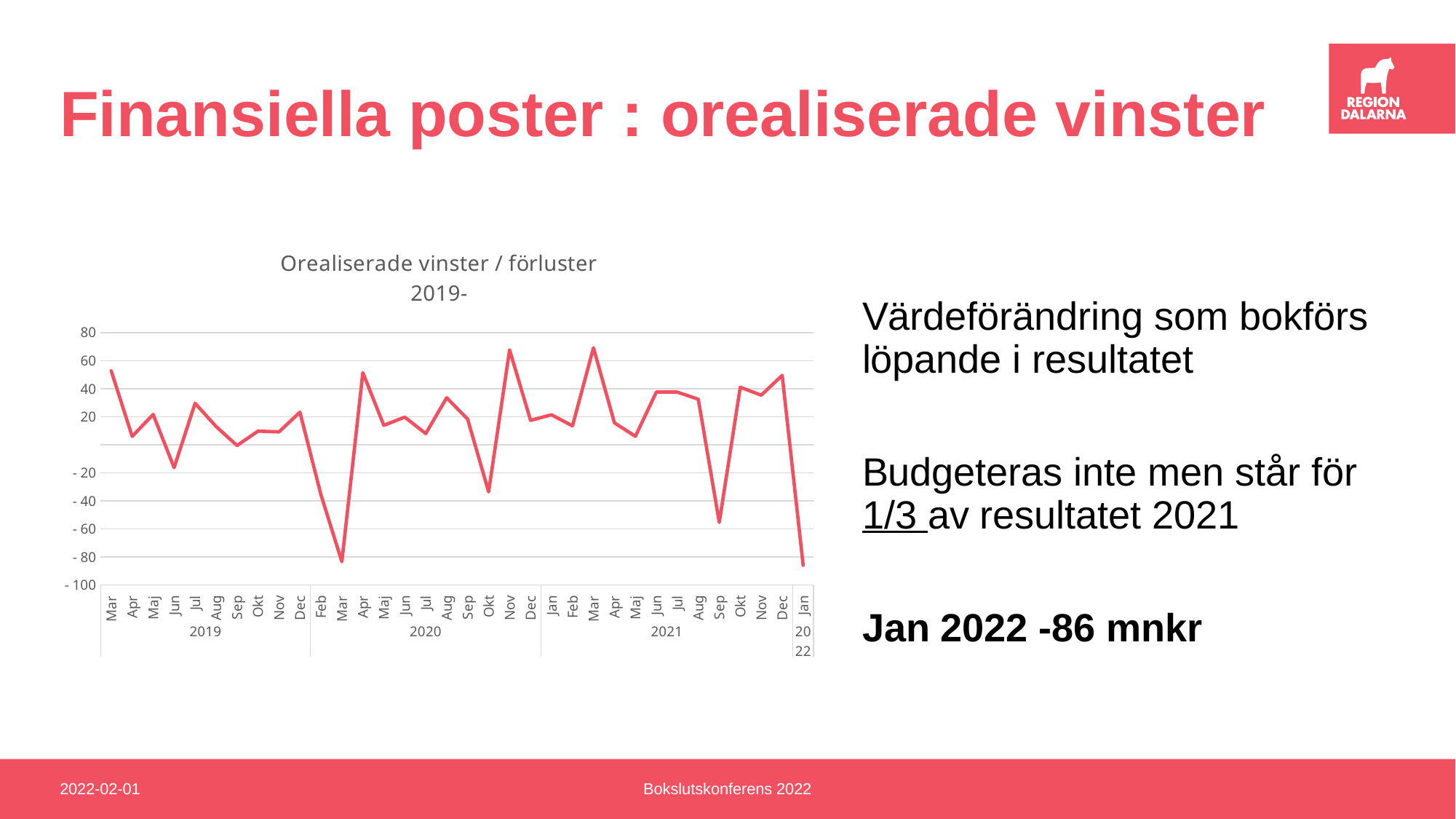
Is the value for Okt 2020 greater or less than -20? less Which is larger, the value for Sep 2021 or the value for Okt 2021? Okt 2021 What is the value for Jan 2022 according to the slide? -86 mnkr Is the value for Mar 2020 greater or less than -60? less How many different years are labelled on the x axis of the chart? 4 What kind of chart is shown on the slide? line chart Which is larger, the value for Mar 2019 or the value for Apr 2019? Mar 2019 Is the value for Sep 2021 greater or less than -40? less What is the highest value shown on the y axis of the chart? 80 What is the title of the chart? Orealiserade vinster / förluster 2019-